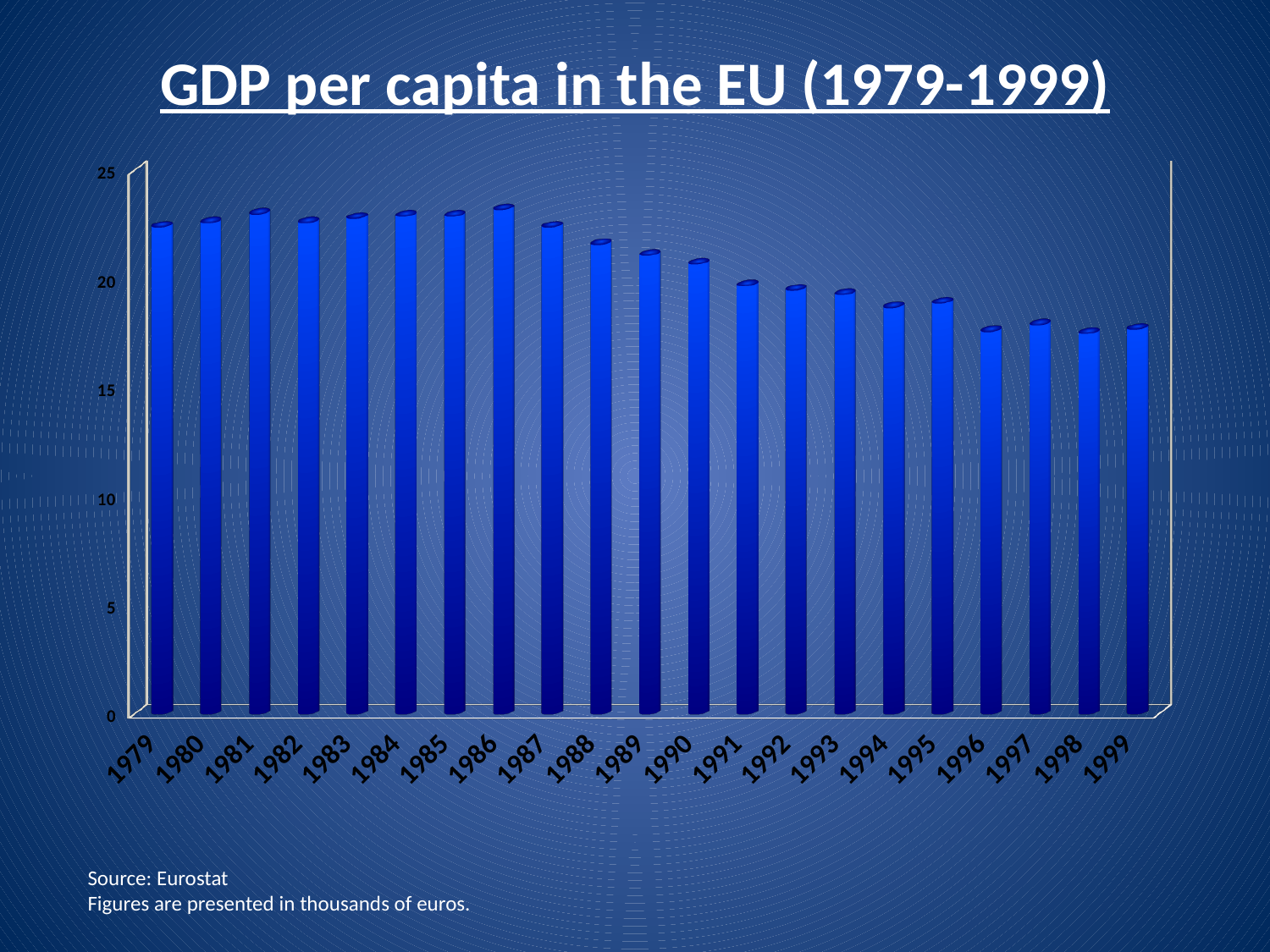
How many years (bars) are plotted in the chart? 21 In what units are the figures presented, according to the note on the slide? Thousands of euros Which year has the larger value, 1979 or 1999? 1979 What is the title of the chart? GDP per capita in the EU (1979-1999) Is the value for 1999 greater or less than 15? greater What type of chart is shown on the slide? Bar chart Is the value for 1986 greater or less than 20? greater Is the value for 1979 greater or less than 20? greater Which year has the larger value, 1986 or 1996? 1986 Do the values generally rise or fall from 1986 to 1999? fall